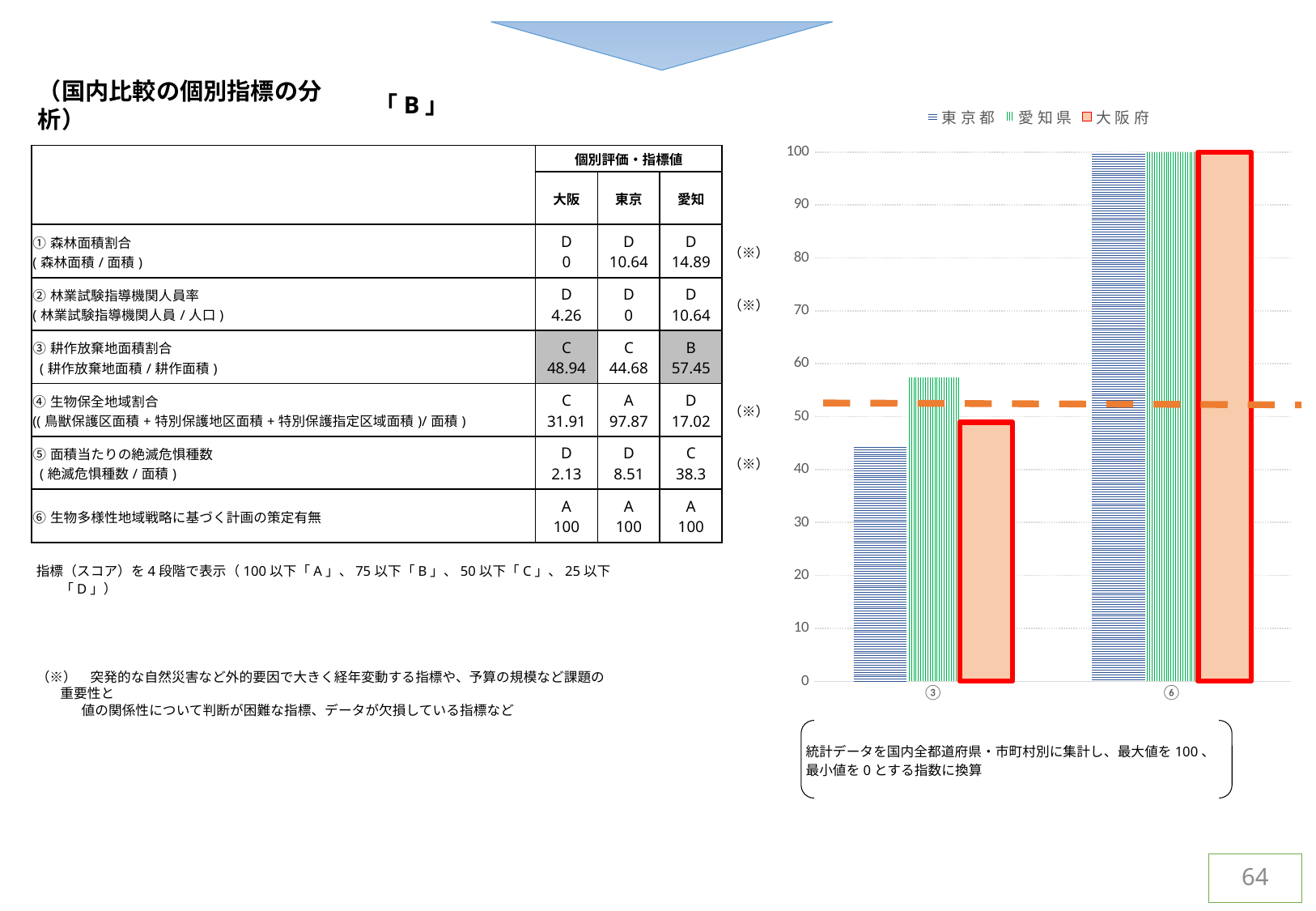
Is the value for 大阪府 at category ③ greater or less than 50? less At category ③, which is larger: the value for 東京都 or the value for 大阪府? 大阪府 Is the value for 愛知県 at category ③ greater or less than 50? greater What is the value for 東京都 at category ⑥ in the bar chart? 100 What is the value for 大阪府 at category ⑥ in the bar chart? 100 What kind of chart is shown on the right side of the slide? bar chart Which series has the highest value at category ③ in the bar chart? 愛知県 How many categories are shown on the x axis of the bar chart? 2 Which series in the bar chart is outlined in red? 大阪府 Is the value for 東京都 at category ③ greater or less than 40? greater Do the values for 大阪府 rise or fall from category ③ to category ⑥? rise How many series does the legend of the bar chart list? 3